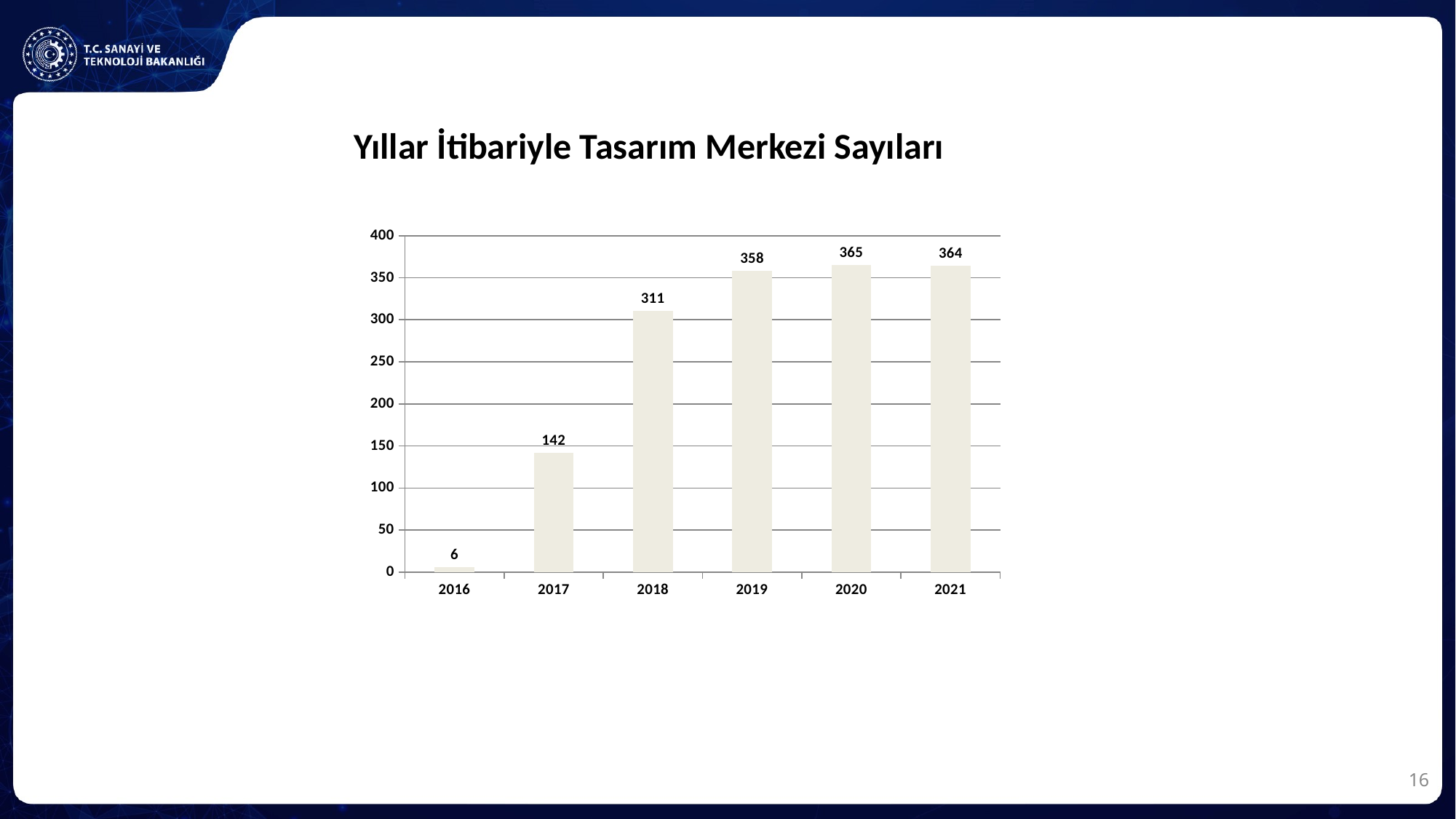
What is the value for 2016? 6 Which year has the lowest value? 2016 What kind of chart is shown on the slide? bar chart Which is larger, the value for 2019 or the value for 2017? 2019 Is the value for 2019 greater or less than 300? greater What is the value for 2018? 311 How many years are shown on the x axis? 6 What is the difference between the values for 2020 and 2021? 1 Which year has the highest value? 2020 What is the difference between the values for 2018 and 2017? 169 What is the value for 2021? 364 What is the title of the chart? Yıllar İtibariyle Tasarım Merkezi Sayıları